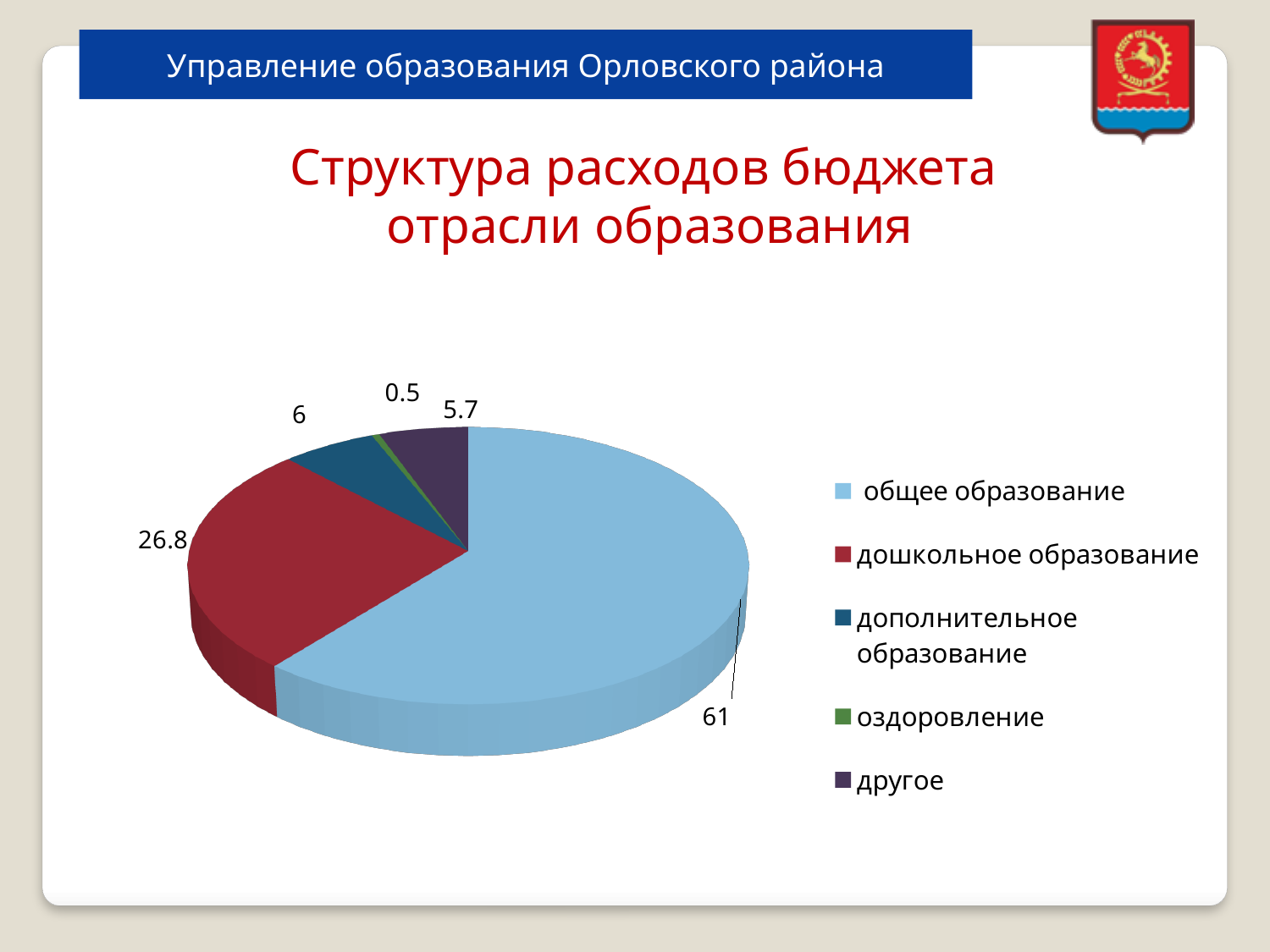
Which category has the largest slice of the pie? общее образование Which category has the smallest slice of the pie? оздоровление What is the value for другое? 5.7 What is the title of the chart on the slide? Структура расходов бюджета отрасли образования What is the value for дошкольное образование? 26.8 What kind of chart is shown on the slide? pie chart What is the difference between the values for общее образование and дошкольное образование? 34.2 What is the value for оздоровление? 0.5 What is the value for дополнительное образование? 6 How many categories does the pie chart have? 5 What is the value for общее образование? 61 Which is larger, the value for дополнительное образование or the value for другое? дополнительное образование